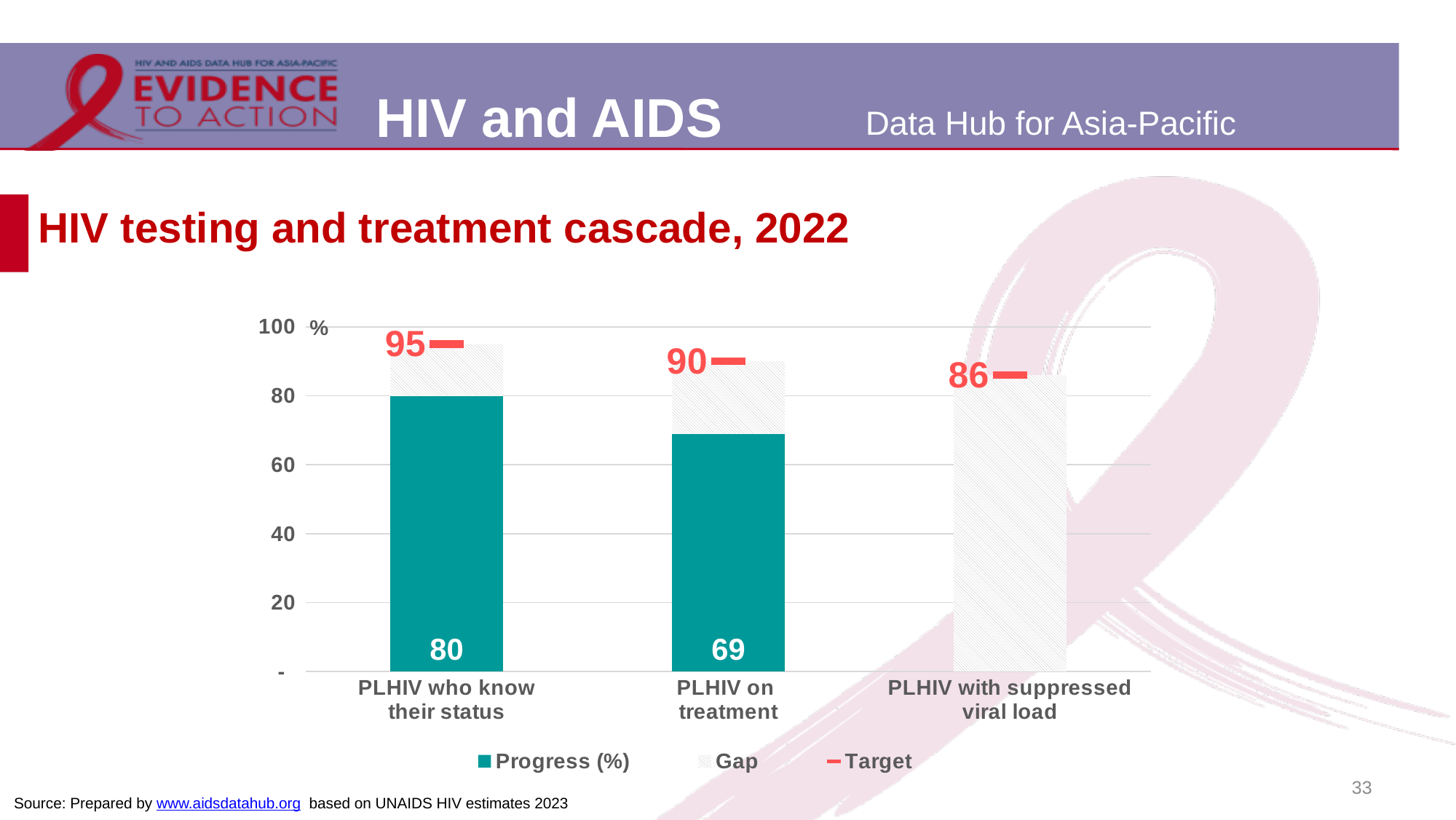
What is the Progress (%) value for PLHIV who know their status? 80 Which is larger: the Progress (%) for PLHIV who know their status or for PLHIV on treatment? PLHIV who know their status Which category has the highest Target value? PLHIV who know their status What is the Target value for PLHIV on treatment? 90 How many series does the chart legend list? 3 What is the difference between the Progress (%) values for PLHIV who know their status and PLHIV on treatment? 11 Which category has the lowest Target value? PLHIV with suppressed viral load What is the Target value for PLHIV with suppressed viral load? 86 What kind of chart is shown on the slide? Bar chart What is the Target value for PLHIV who know their status? 95 What is the Progress (%) value for PLHIV on treatment? 69 How many categories are shown on the x axis of the chart? 3